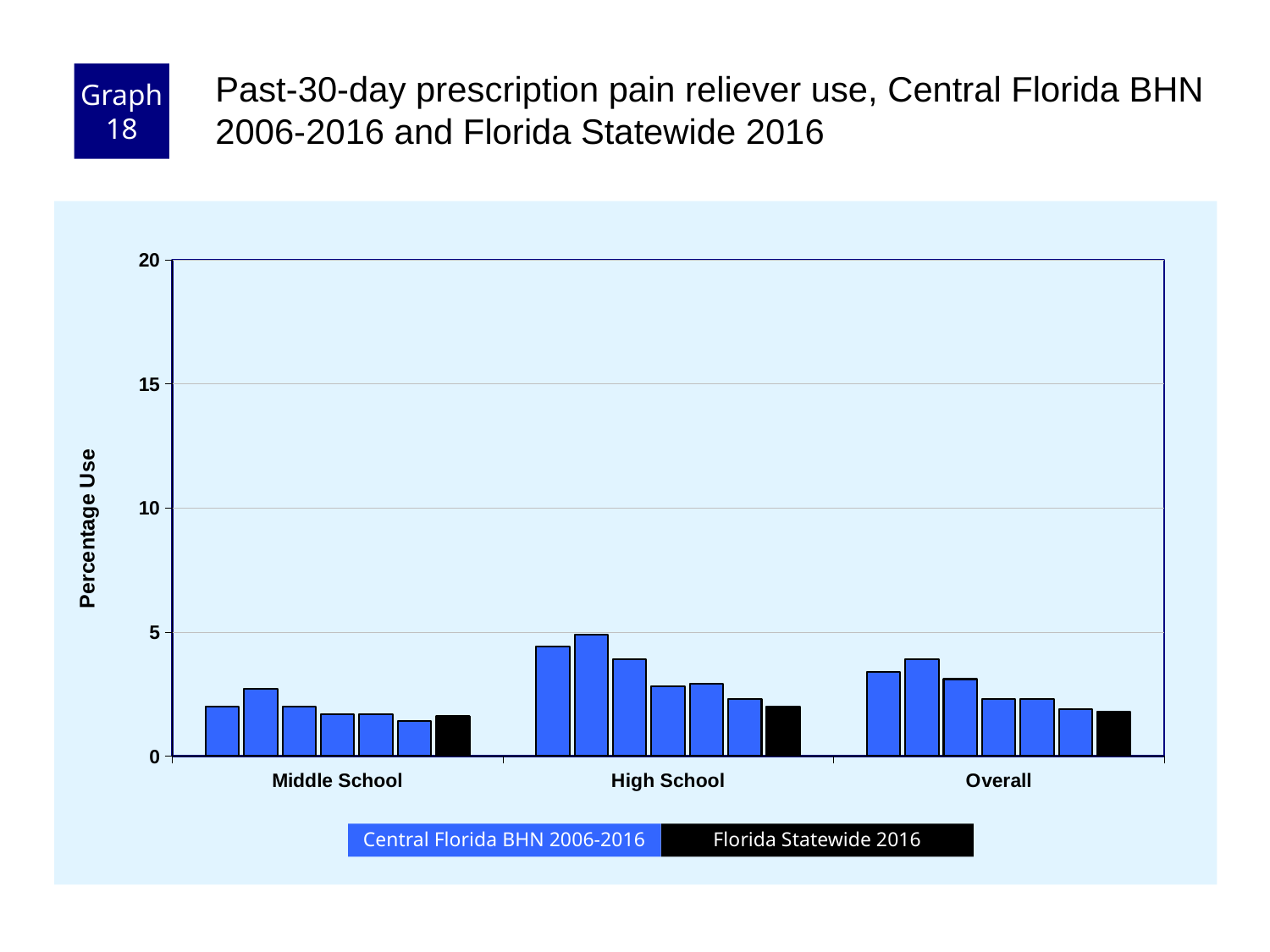
How many category groups are shown on the x axis? 3 Which category group has the lowest bars overall? Middle School What is the label on the y axis? Percentage Use Is the Florida Statewide 2016 value for Middle School greater or less than 5? less Which is larger: the Florida Statewide 2016 value for High School or for Middle School? High School What kind of chart is shown on the slide? bar chart Which category group contains the tallest bar? High School Are any of the bars on the chart greater than 10? No How many series does the legend list? 2 Which series is shown in black in the legend? Florida Statewide 2016 How many bars are plotted in the High School group? 7